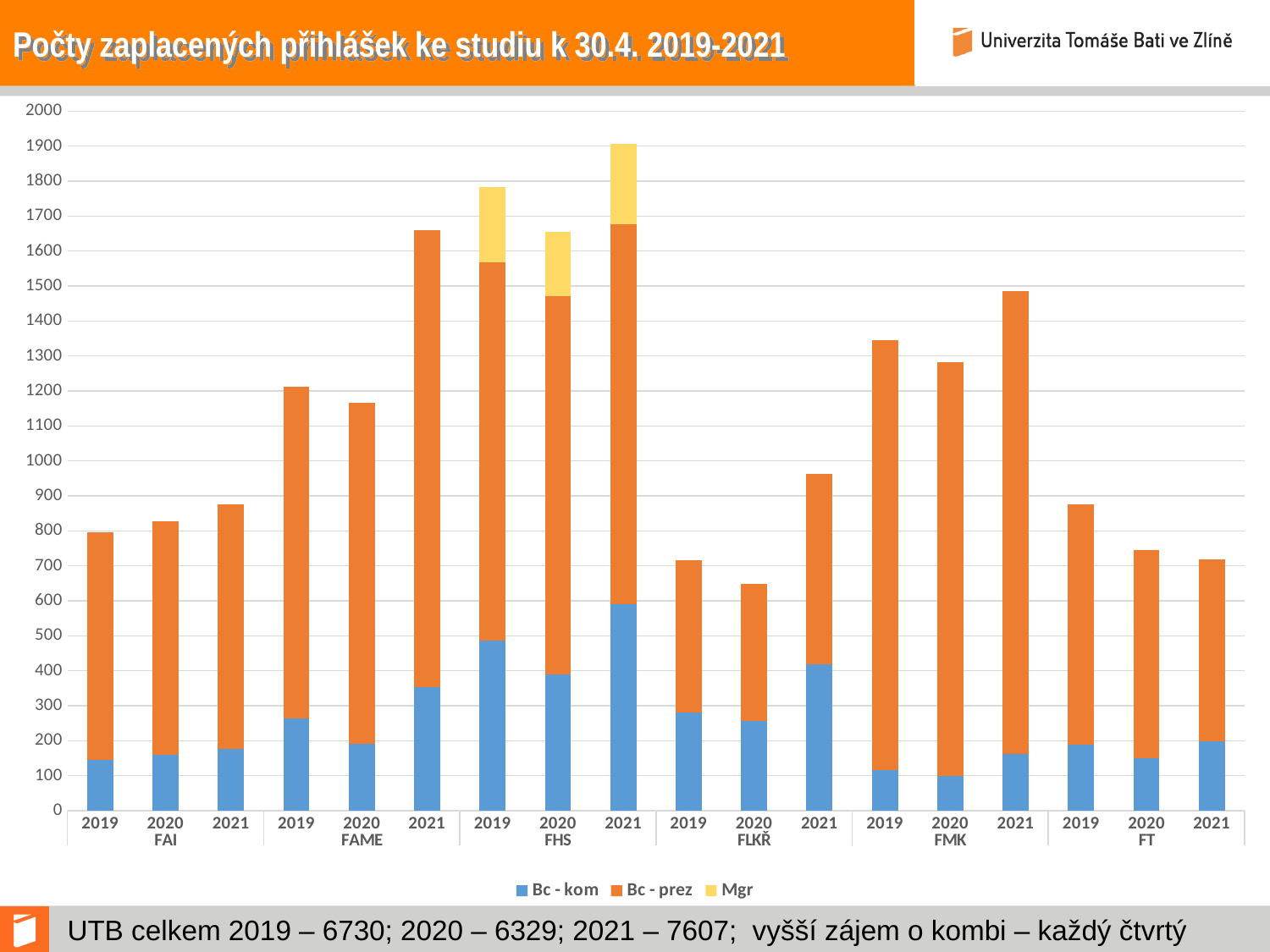
Do the total values for FAI rise or fall from 2019 to 2021? rise How many series does the legend list? 3 Is the total value for FHS 2021 greater or less than 1800? greater What kind of chart is shown on the slide? stacked bar chart How many bars are plotted in the chart? 18 Which faculty and year has the tallest bar? FHS 2021 Is the total value for FMK 2021 greater or less than 1400? greater What is the title of the chart on the slide? Počty zaplacených přihlášek ke studiu k 30.4. 2019-2021 Is the total value for FLKŘ 2020 greater or less than 700? less Which faculty and year has the shortest bar? FLKŘ 2020 Which faculty is the only one with a visible Mgr (yellow) segment? FHS Which is larger, the total bar for FMK 2019 or FMK 2020? FMK 2019